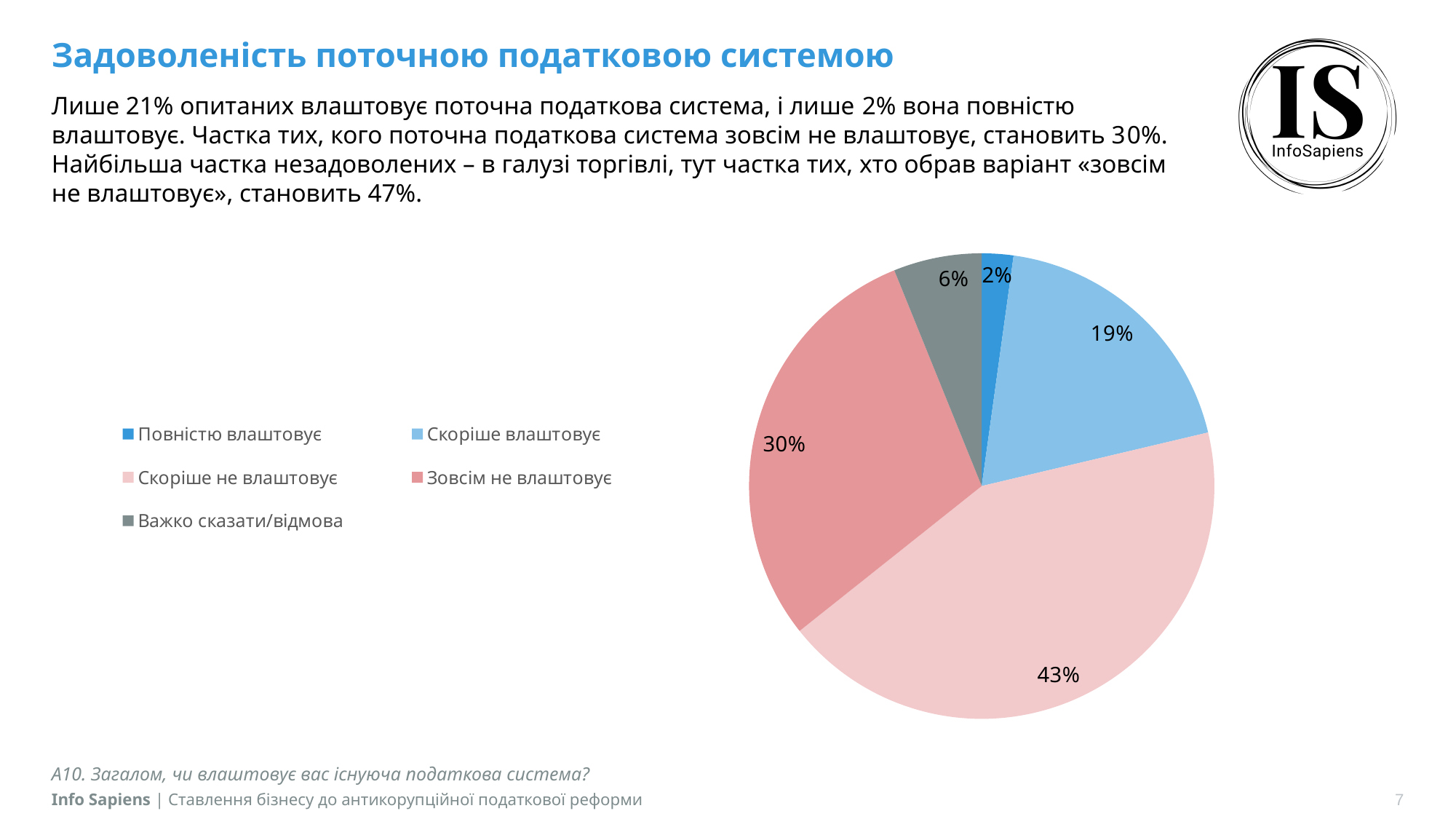
What share of respondents chose "Повністю влаштовує"? 2% What share of respondents chose "Важко сказати/відмова"? 6% What kind of chart is shown on the slide? pie chart How many categories does the legend list? 5 Which is larger: the share for "Скоріше влаштовує" or the share for "Важко сказати/відмова"? Скоріше влаштовує What colour is the slice for "Важко сказати/відмова"? grey What share of respondents chose "Зовсім не влаштовує"? 30% What is the difference between the shares for "Скоріше не влаштовує" and "Зовсім не влаштовує"? 13% What share of respondents chose "Скоріше не влаштовує"? 43% Which category has the largest slice of the pie? Скоріше не влаштовує Which category has the smallest slice of the pie? Повністю влаштовує What share of respondents chose "Скоріше влаштовує"? 19%